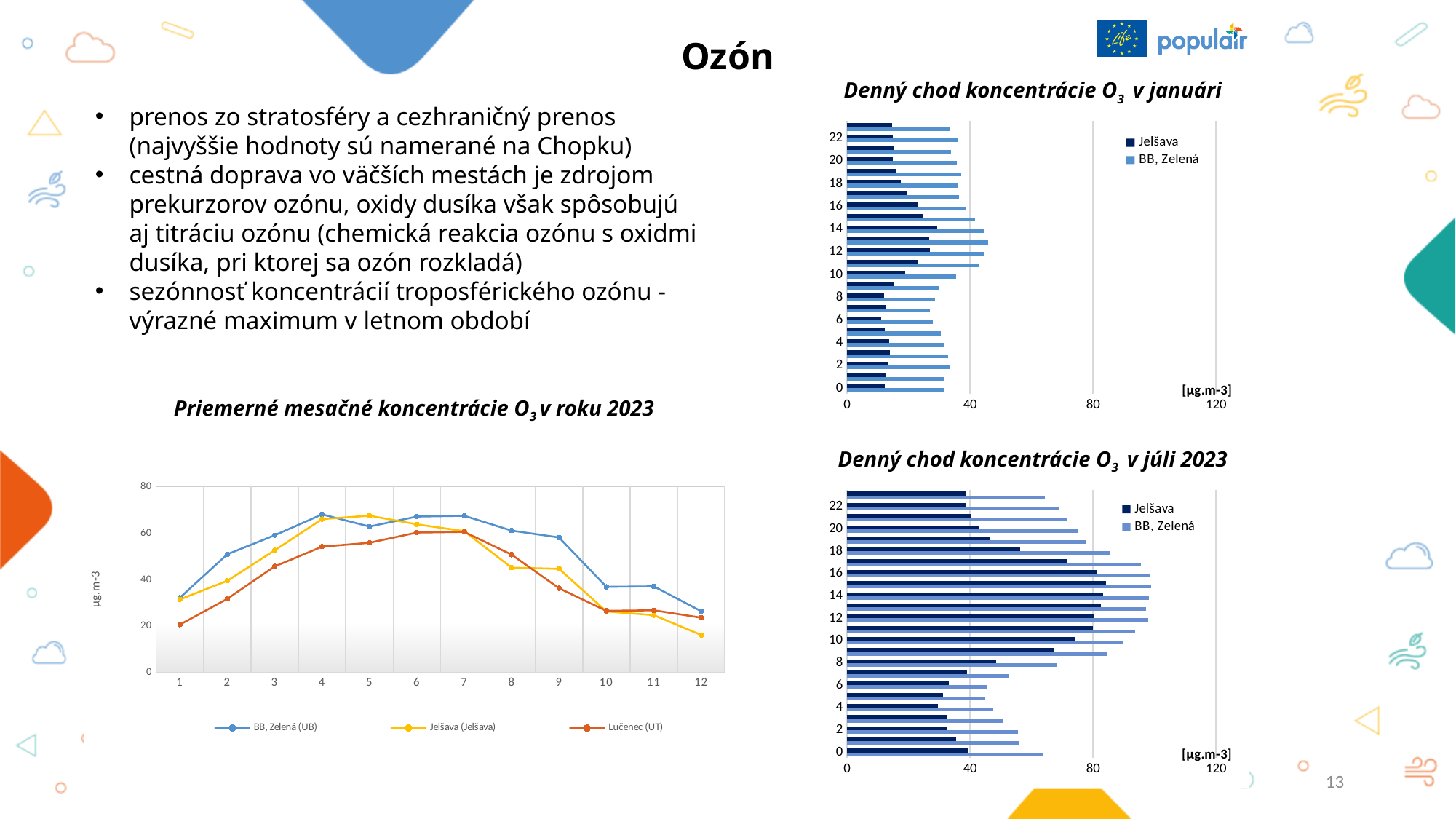
In 'Priemerné mesačné koncentrácie O3 v roku 2023', is the BB, Zelená (UB) value in month 7 greater or less than 60? greater How many months are plotted on the x axis of 'Priemerné mesačné koncentrácie O3 v roku 2023'? 12 How many series does the legend of 'Denný chod koncentrácie O3 v júli 2023' list? 2 In 'Denný chod koncentrácie O3 v januári', is the BB, Zelená value at hour 13 greater or less than 40? greater In 'Priemerné mesačné koncentrácie O3 v roku 2023', in which month is the Lučenec (UT) value lowest? 1 In 'Denný chod koncentrácie O3 v júli 2023', which series has the larger value at hour 0: Jelšava or BB, Zelená? BB, Zelená How many series does the legend of 'Priemerné mesačné koncentrácie O3 v roku 2023' list? 3 In 'Priemerné mesačné koncentrácie O3 v roku 2023', which series has the larger value in month 1: BB, Zelená (UB) or Lučenec (UT)? BB, Zelená (UB) What kind of chart is 'Denný chod koncentrácie O3 v januári'? bar chart In 'Denný chod koncentrácie O3 v júli 2023', is the Jelšava value at hour 6 greater or less than 40? less In 'Priemerné mesačné koncentrácie O3 v roku 2023', in which month is the Jelšava (Jelšava) value lowest? 12 What kind of chart is 'Priemerné mesačné koncentrácie O3 v roku 2023'? line chart